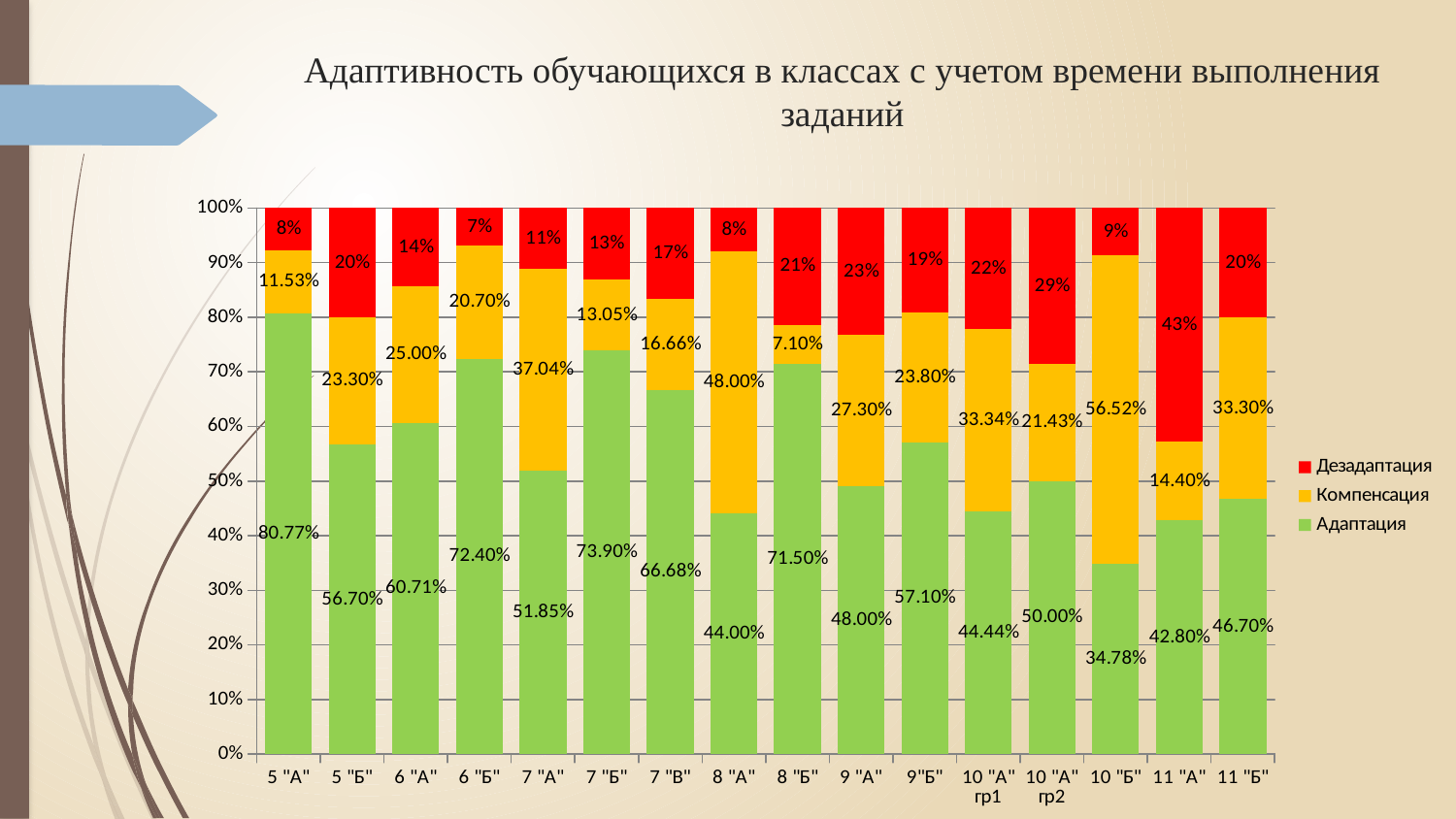
Which is larger: the Адаптация value for 7 "Б" or for 7 "А"? 7 "Б" What is the difference between the Адаптация values for 5 "А" and 10 "Б"? 45.99% Which class has the lowest Компенсация value? 8 "Б" How many classes (categories) are shown on the x axis? 16 What is the Дезадаптация value for class 11 "А"? 43% Which class has the highest Адаптация value? 5 "А" What is the Адаптация value for class 5 "А"? 80.77% What kind of chart is shown on the slide? Stacked bar chart What is the Компенсация value for class 10 "Б"? 56.52% Which class has the highest Дезадаптация value? 11 "А" Which class has the lowest Адаптация value? 10 "Б" How many series does the legend list? 3